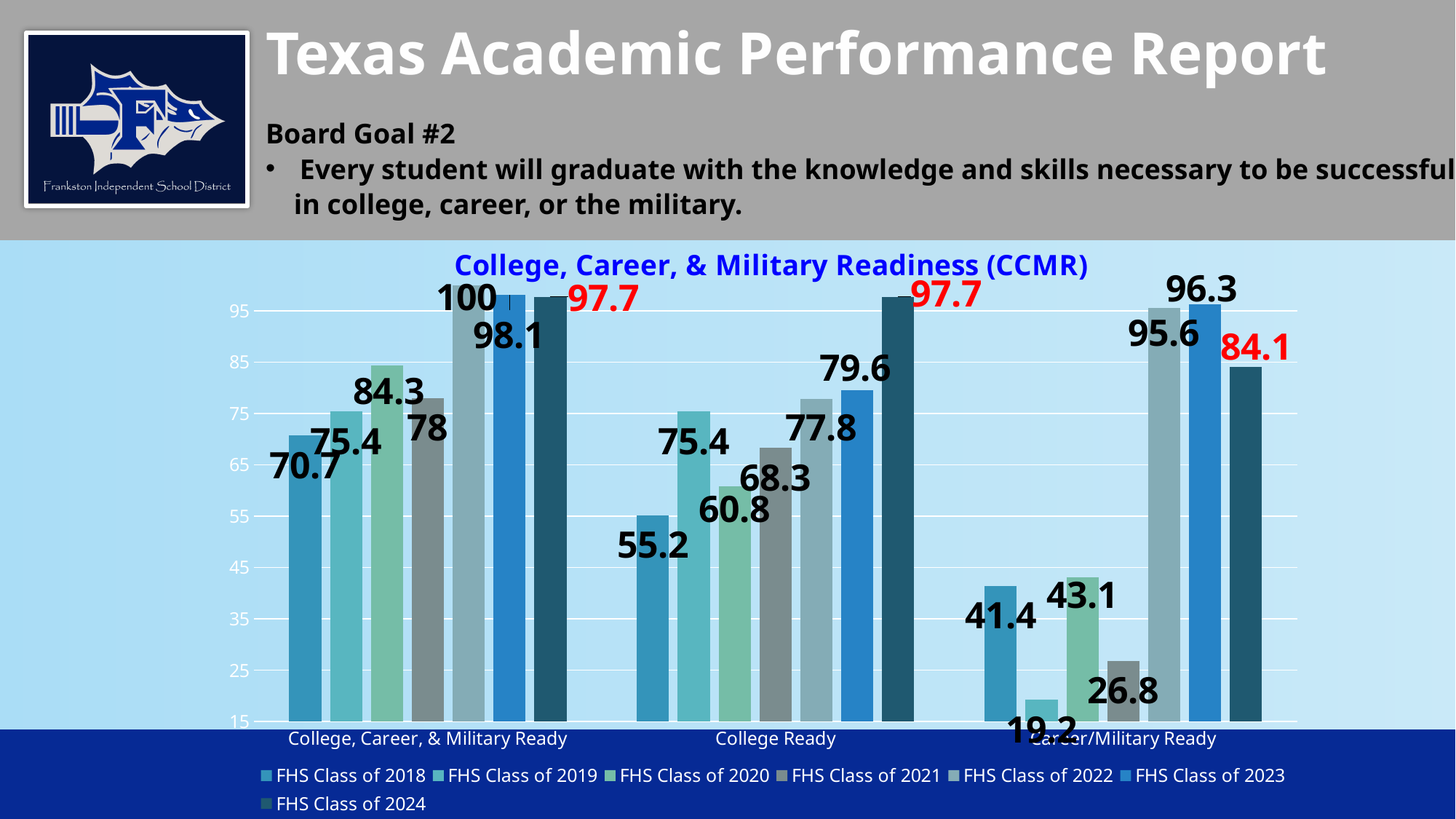
What is the title of the chart? College, Career, & Military Readiness (CCMR) What is the value for FHS Class of 2024 in the Career/Military Ready category? 84.1 What is the value for FHS Class of 2019 in the Career/Military Ready category? 19.2 Which class has the lowest value in the College Ready category? FHS Class of 2018 What is the difference between the FHS Class of 2024 and FHS Class of 2018 values in the College Ready category? 42.5 In the College, Career, & Military Ready category, which is larger: FHS Class of 2020 or FHS Class of 2021? FHS Class of 2020 What kind of chart is shown on the slide? bar chart How many categories are shown on the x axis? 3 Which class has the highest value in the Career/Military Ready category? FHS Class of 2023 How many series does the legend list? 7 Is the value for FHS Class of 2021 in the Career/Military Ready category greater or less than 35? less What is the value for FHS Class of 2022 in the College, Career, & Military Ready category? 100